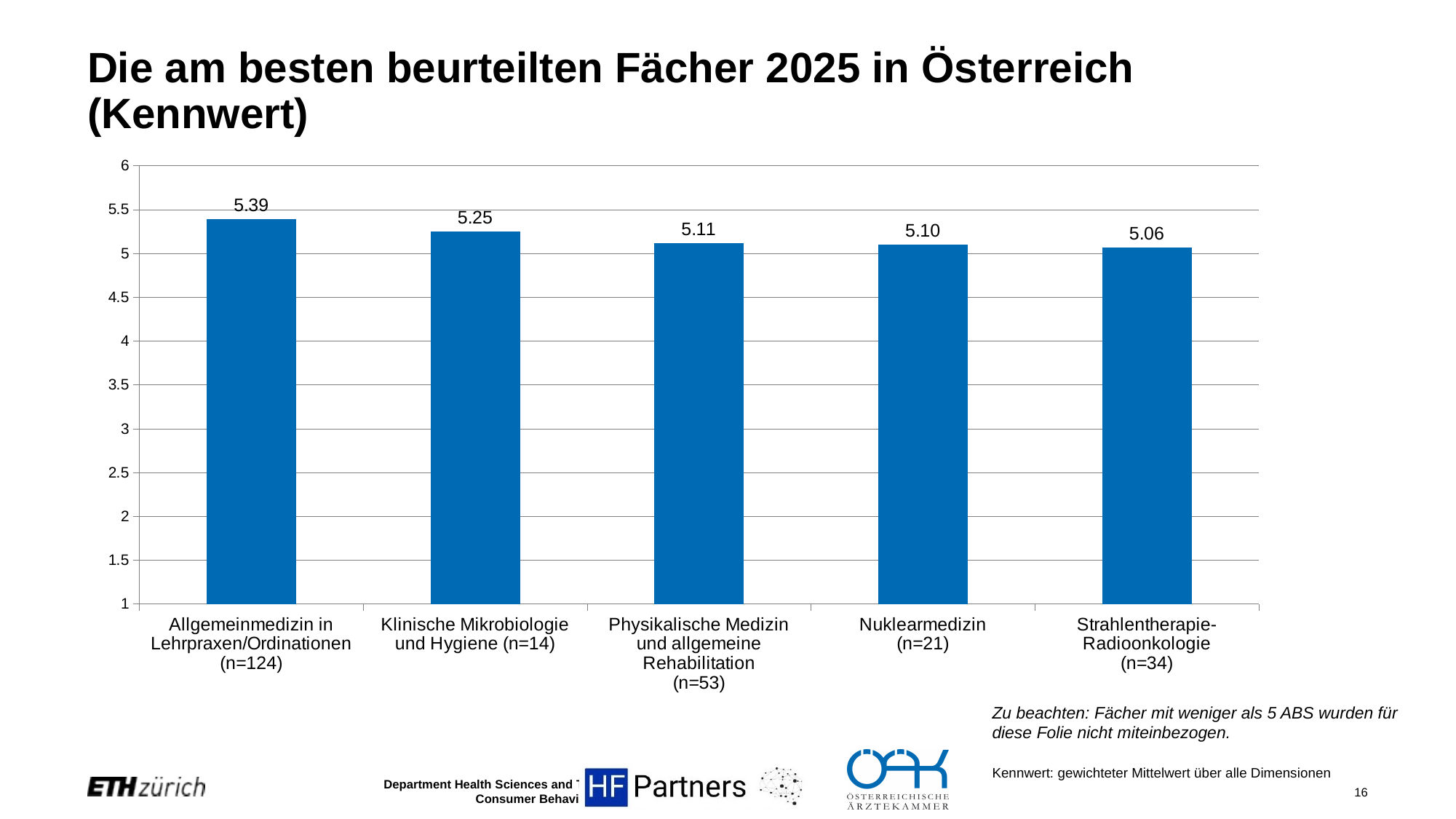
What is the difference between the Kennwert for Allgemeinmedizin in Lehrpraxen/Ordinationen and Klinische Mikrobiologie und Hygiene? 0.14 What is the Kennwert for Strahlentherapie-Radioonkologie (n=34)? 5.06 What is the Kennwert for Allgemeinmedizin in Lehrpraxen/Ordinationen (n=124)? 5.39 What kind of chart is shown on the slide? Bar chart What is the Kennwert for Klinische Mikrobiologie und Hygiene (n=14)? 5.25 Do the values rise or fall from left to right across the chart? Fall Which subject has the lowest Kennwert? Strahlentherapie-Radioonkologie (n=34) Which subject has the highest Kennwert? Allgemeinmedizin in Lehrpraxen/Ordinationen (n=124) Which has a higher Kennwert: Klinische Mikrobiologie und Hygiene or Nuklearmedizin? Klinische Mikrobiologie und Hygiene What is the difference between the Kennwert for Physikalische Medizin und allgemeine Rehabilitation and Strahlentherapie-Radioonkologie? 0.05 How many subjects are shown in the chart? 5 What is the Kennwert for Nuklearmedizin (n=21)? 5.10